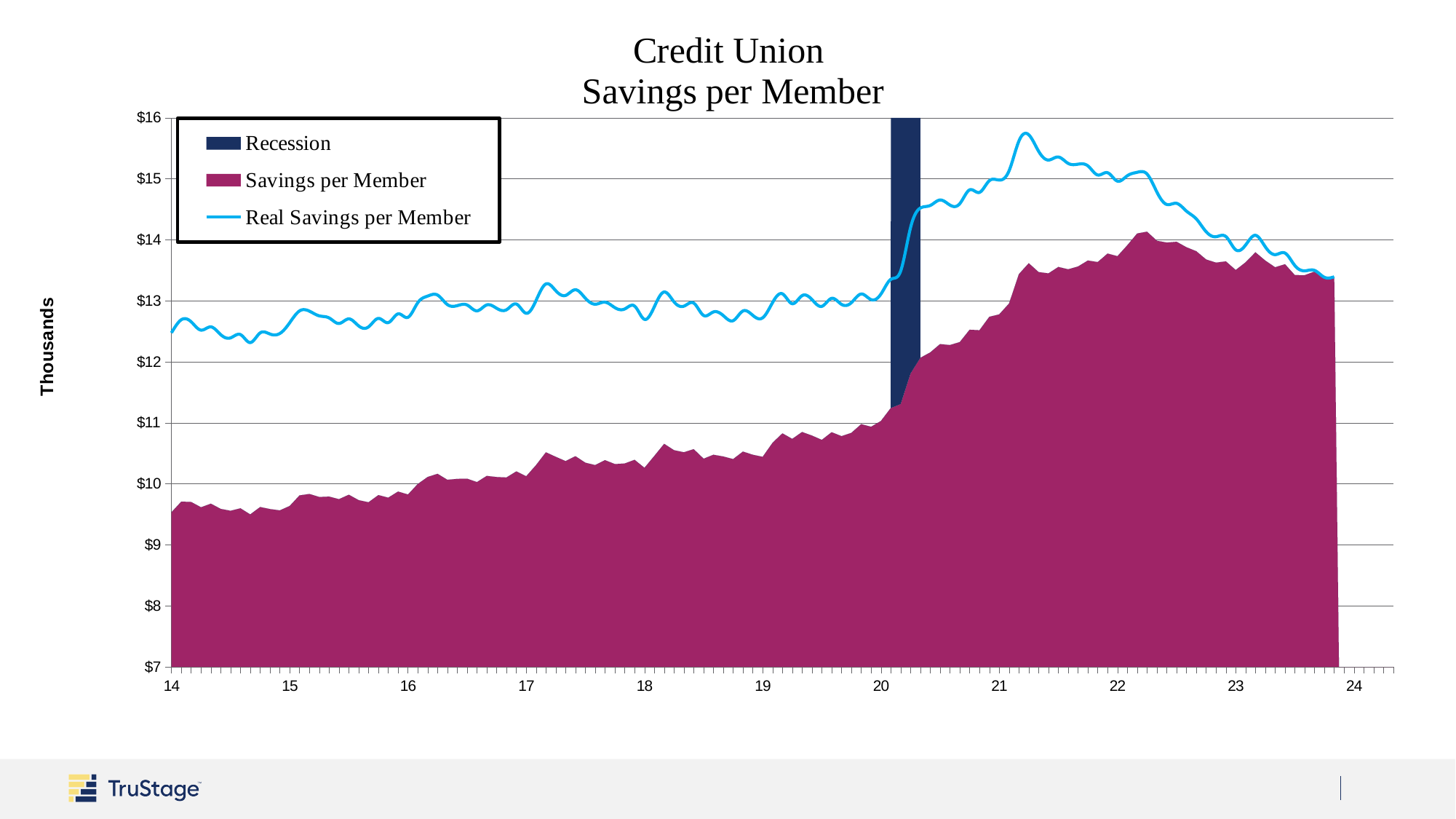
How many series does the legend list? 3 Does Real Savings per Member rise or fall from 21 to 24? fall Is the value for Savings per Member at 14 greater or less than $10? less What is the label on the vertical axis? Thousands Is the value for Real Savings per Member at 14 greater or less than $12? greater What kind of chart is shown on the slide? Area chart with a line series Is the value for Savings per Member at 22 greater or less than $13? greater What is the title of the chart? Credit Union Savings per Member Does Savings per Member rise or fall from 14 to 22? rise At 14, which is larger: Savings per Member or Real Savings per Member? Real Savings per Member